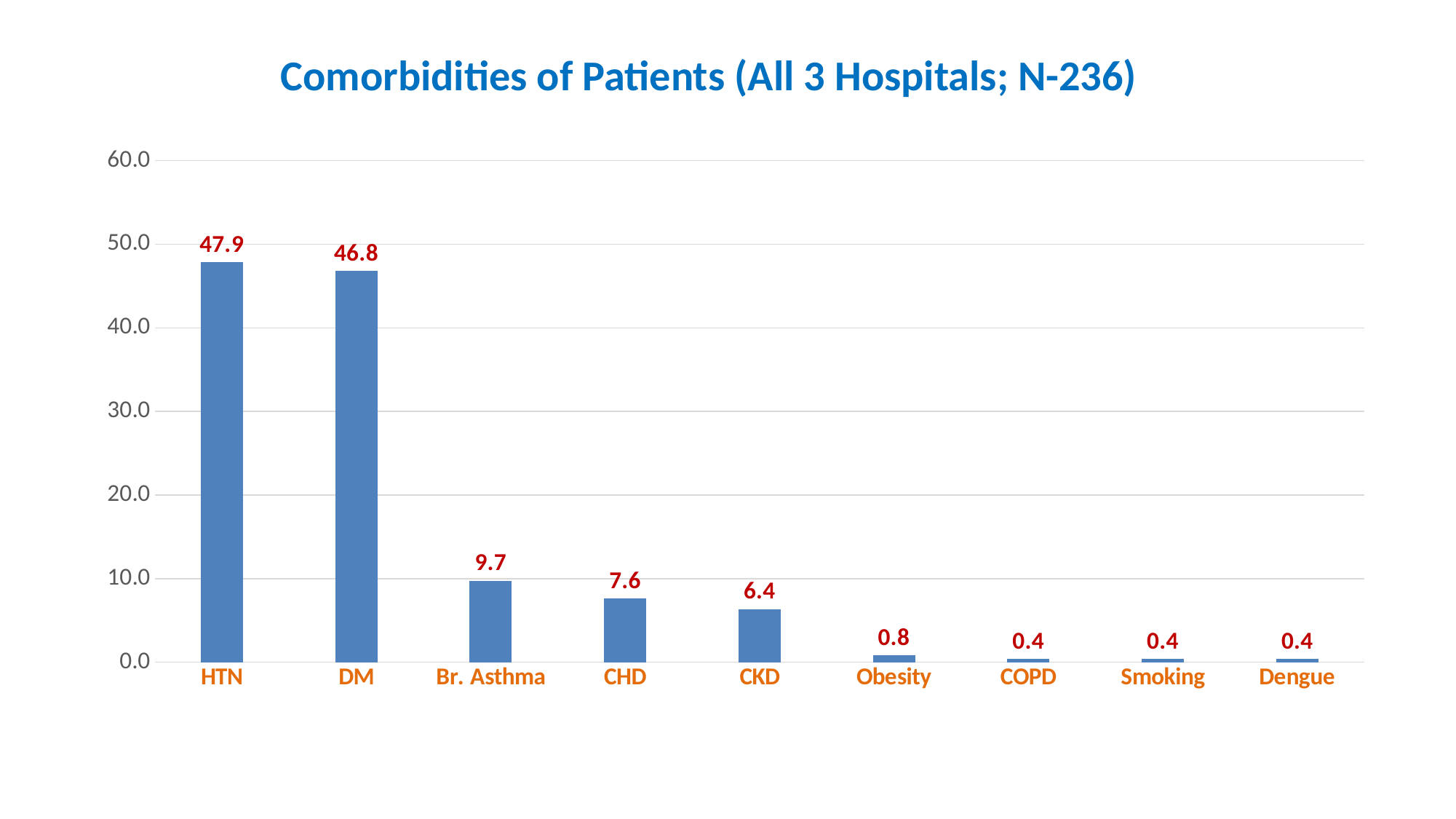
What is the value for Obesity? 0.8 What is the difference between the values for CHD and CKD? 1.2 What is the value for CKD? 6.4 What kind of chart is shown on the slide? Bar chart What is the value for HTN? 47.9 Is the value for DM greater or less than 40.0? greater Which comorbidity has the highest value? HTN Which is larger, the value for Br. Asthma or the value for CHD? Br. Asthma What is the value for Br. Asthma? 9.7 What is the title of the chart? Comorbidities of Patients (All 3 Hospitals; N-236) How many comorbidity categories are shown on the chart? 9 What is the difference between the values for HTN and DM? 1.1